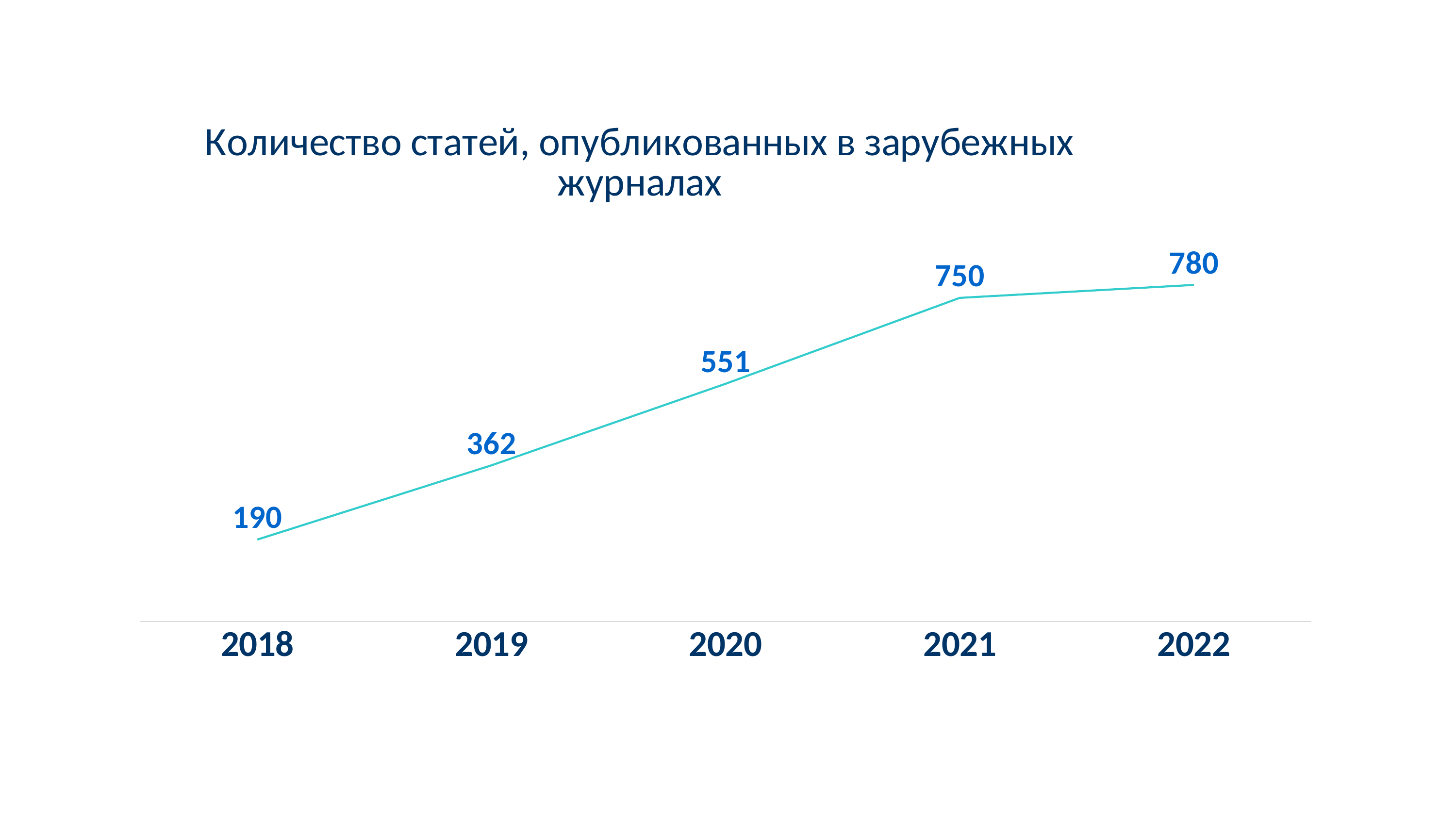
Which is larger, the value for 2019 or the value for 2020? 2020 What is the difference between the values for 2022 and 2018? 590 Do the values rise or fall from 2018 to 2022? rise What is the title of the chart? Количество статей, опубликованных в зарубежных журналах Which year has the highest value? 2022 Which year has the lowest value? 2018 What is the difference between the values for 2021 and 2020? 199 What kind of chart is shown on the slide? line chart What is the value for 2022? 780 What is the value for 2020? 551 How many years are plotted on the chart? 5 What is the value for 2018? 190